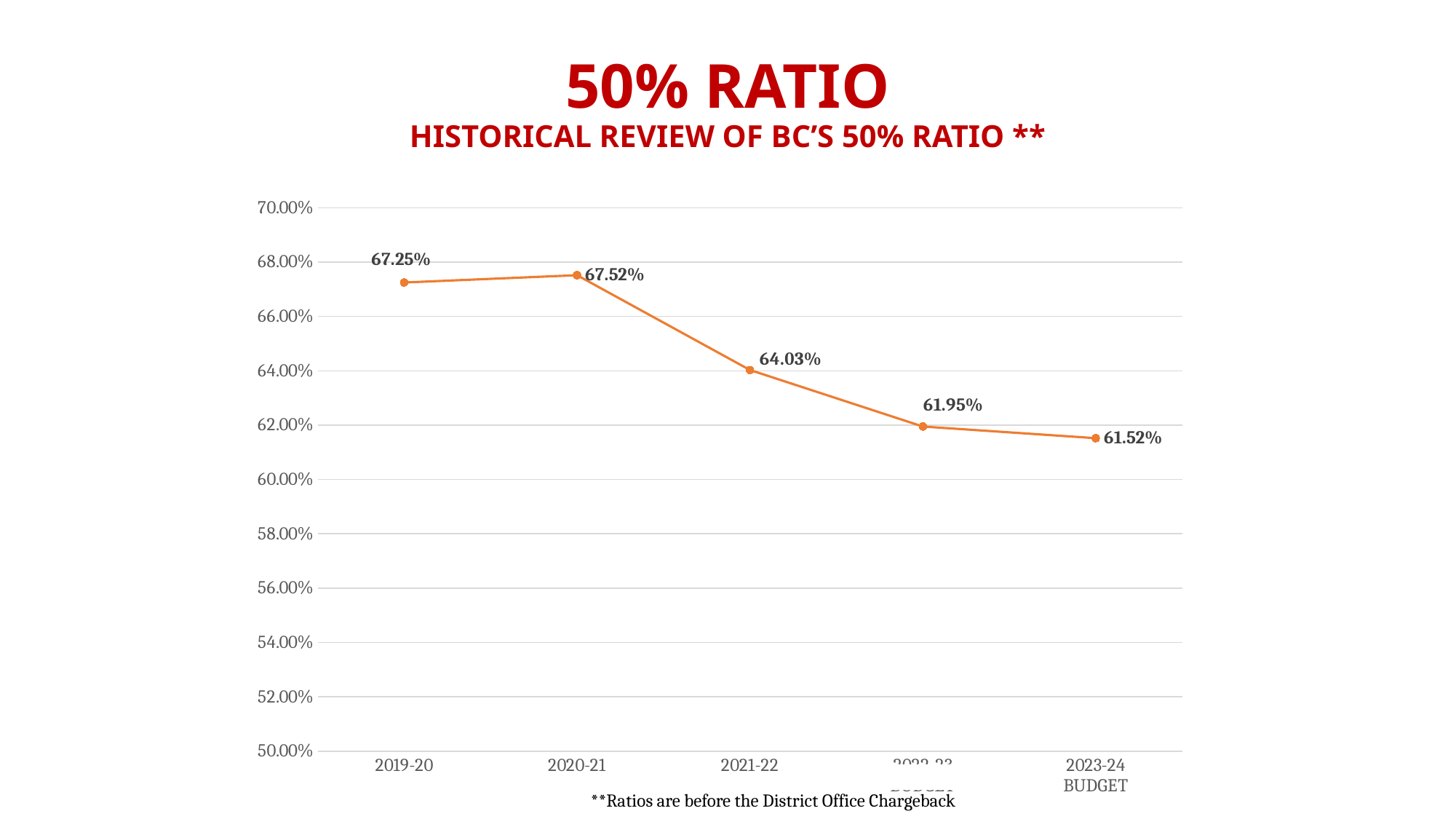
What is the difference between the values for 2020-21 and 2021-22? 3.49% What is the value for 2023-24 BUDGET? 61.52% Do the values generally rise or fall from 2019-20 to 2023-24 BUDGET? fall Which year has the lowest ratio? 2023-24 BUDGET How many data points are plotted on the chart? 5 Which is larger, the value for 2019-20 or the value for 2020-21? 2020-21 What is the value for 2019-20? 67.25% Which year has the highest ratio? 2020-21 Is the value for 2021-22 greater or less than 66.00%? less What is the value for 2020-21? 67.52% What is the value for 2021-22? 64.03% What kind of chart is shown on the slide? line chart